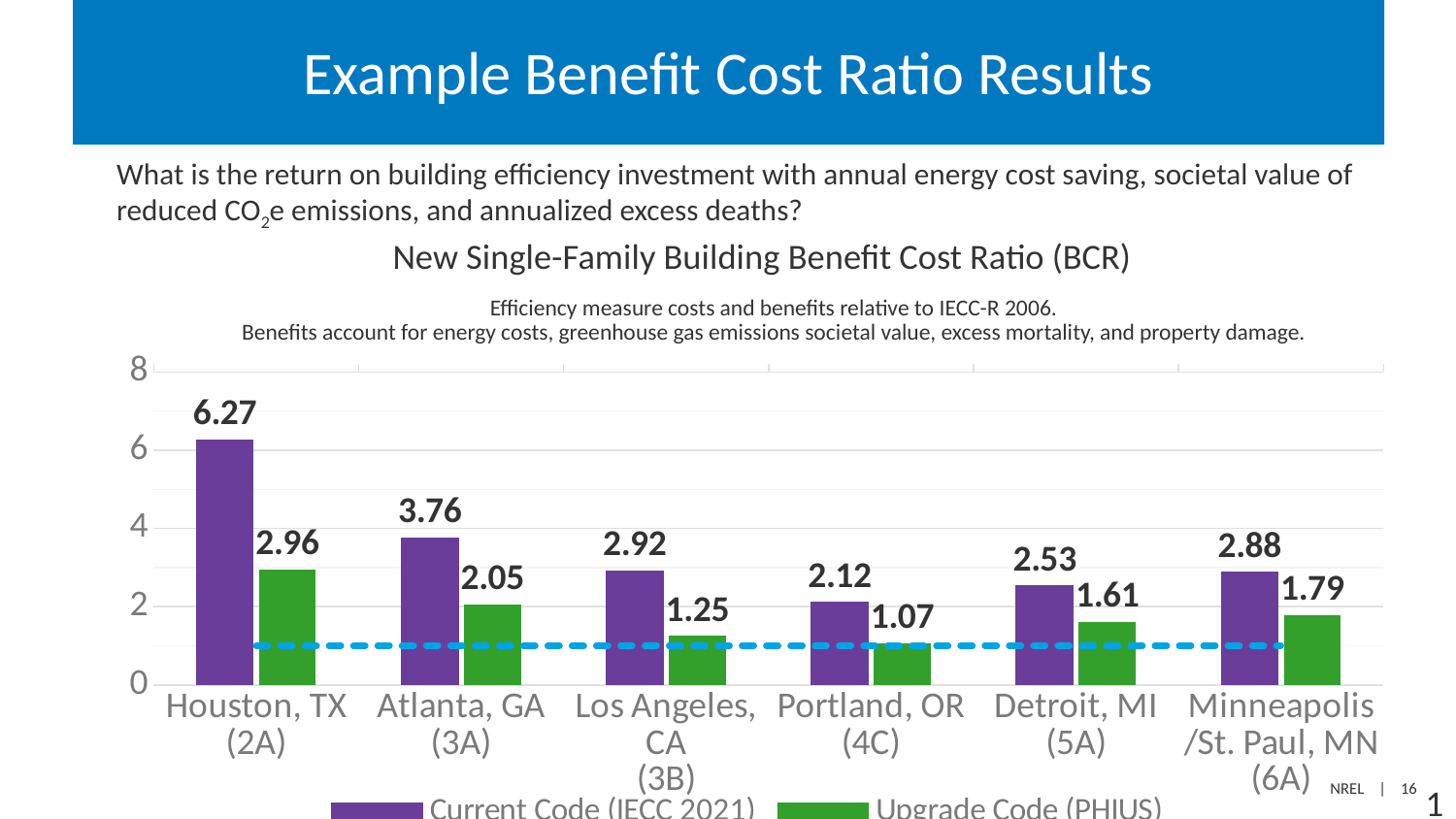
Which city has the lowest Upgrade Code (PHIUS) benefit cost ratio? Portland, OR (4C) How many series does the chart legend list? 2 How many cities are shown on the x axis of the chart? 6 Which colour represents the Upgrade Code (PHIUS) series? Green What is the difference between the Current Code and Upgrade Code values for Atlanta, GA (3A)? 1.71 What is the Current Code (IECC 2021) benefit cost ratio for Houston, TX (2A)? 6.27 Which city has the highest Current Code (IECC 2021) benefit cost ratio? Houston, TX (2A) What is the Upgrade Code (PHIUS) value for Minneapolis/St. Paul, MN (6A)? 1.79 What kind of chart is shown on the slide? Bar chart Which is larger: the Current Code value for Detroit, MI (5A) or the Current Code value for Los Angeles, CA (3B)? Los Angeles, CA (3B) Is the Upgrade Code (PHIUS) value for Houston, TX (2A) greater or less than 2? greater What is the Upgrade Code (PHIUS) benefit cost ratio for Portland, OR (4C)? 1.07